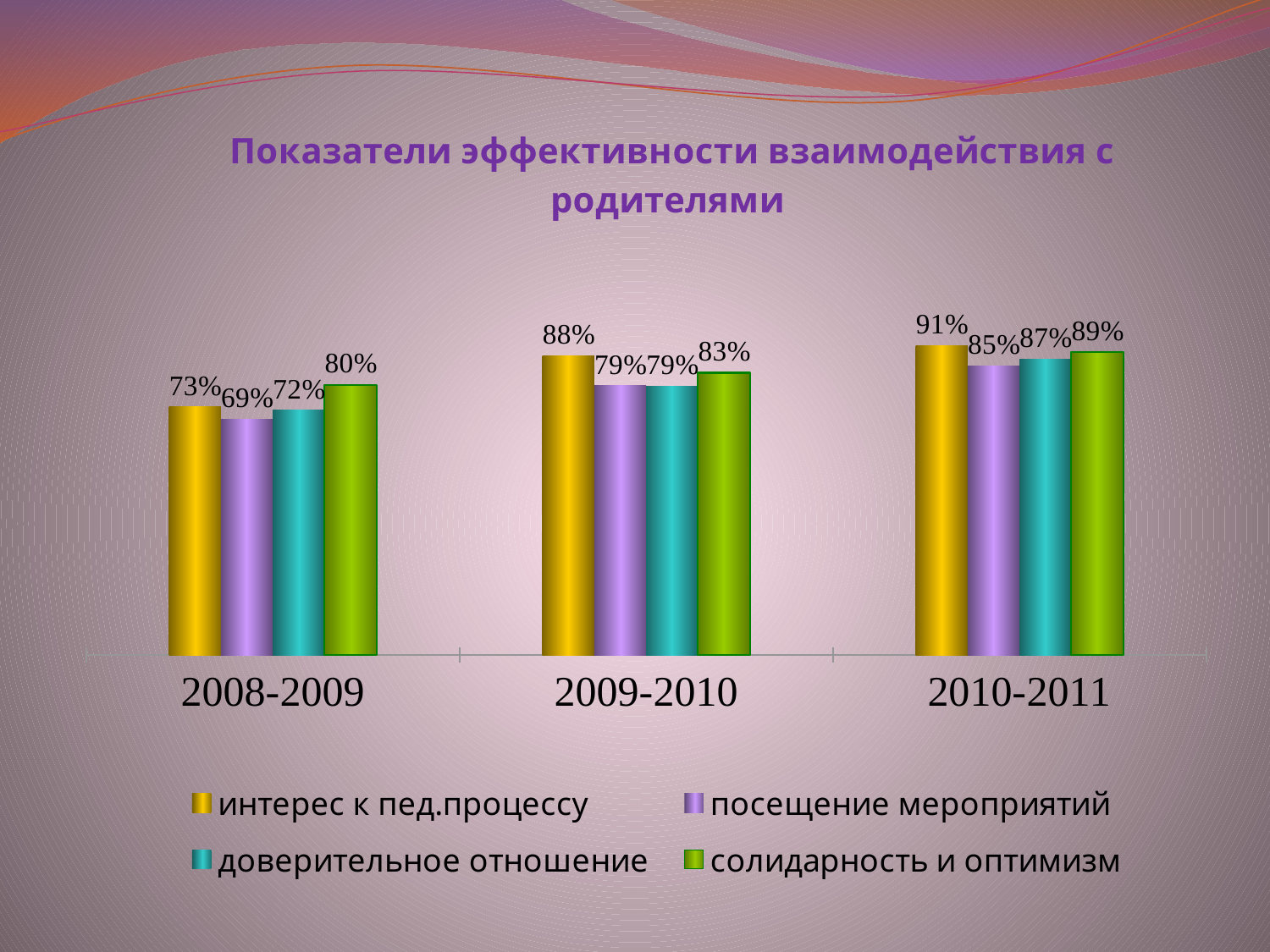
How many series does the legend list? 4 What is the value for 'интерес к пед.процессу' in 2008-2009? 73% What is the value for 'солидарность и оптимизм' in 2009-2010? 83% Which is larger in 2009-2010: 'интерес к пед.процессу' or 'солидарность и оптимизм'? интерес к пед.процессу What is the value for 'посещение мероприятий' in 2010-2011? 85% What is the difference between 'интерес к пед.процессу' in 2010-2011 and in 2008-2009? 18% Which series has the lowest value in 2008-2009? посещение мероприятий What kind of chart is shown on the slide? bar chart Do the values for 'солидарность и оптимизм' rise or fall from 2008-2009 to 2010-2011? rise What is the value for 'доверительное отношение' in 2008-2009? 72% In which period is 'интерес к пед.процессу' highest? 2010-2011 How many periods are shown on the x axis? 3